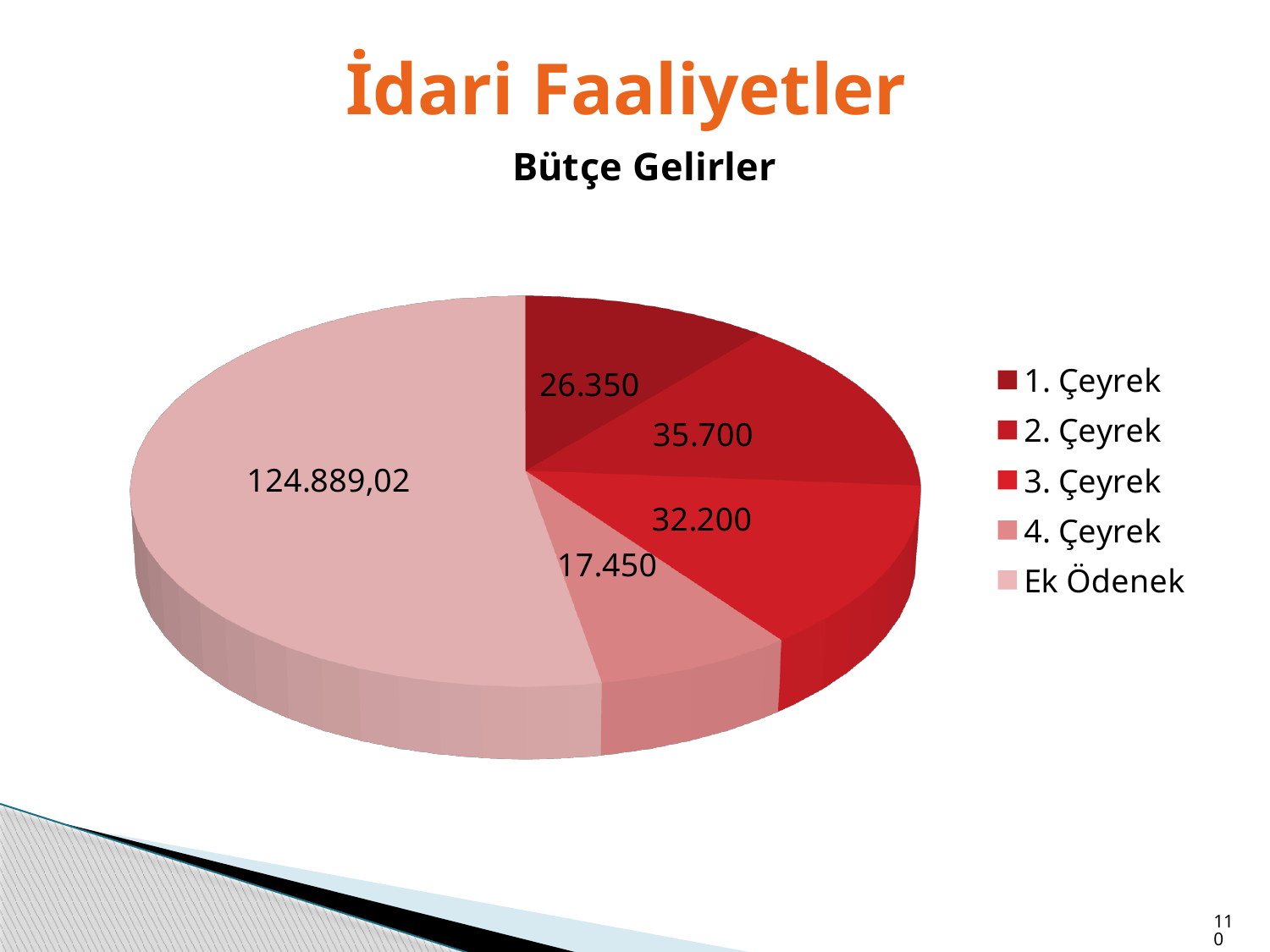
What is the value for 1. Çeyrek? 26.350 What is the value for 2. Çeyrek? 35.700 What is the value for Ek Ödenek? 124.889,02 Which is larger, the value for 1. Çeyrek or the value for 4. Çeyrek? 1. Çeyrek What is the value for 4. Çeyrek? 17.450 How many categories does the legend list? 5 Which category has the smallest slice of the pie? 4. Çeyrek What is the value for 3. Çeyrek? 32.200 What is the difference between the values for 2. Çeyrek and 3. Çeyrek? 3.500 What is the title of the chart? Bütçe Gelirler Which category has the largest slice of the pie? Ek Ödenek What type of chart is shown on the slide? Pie chart